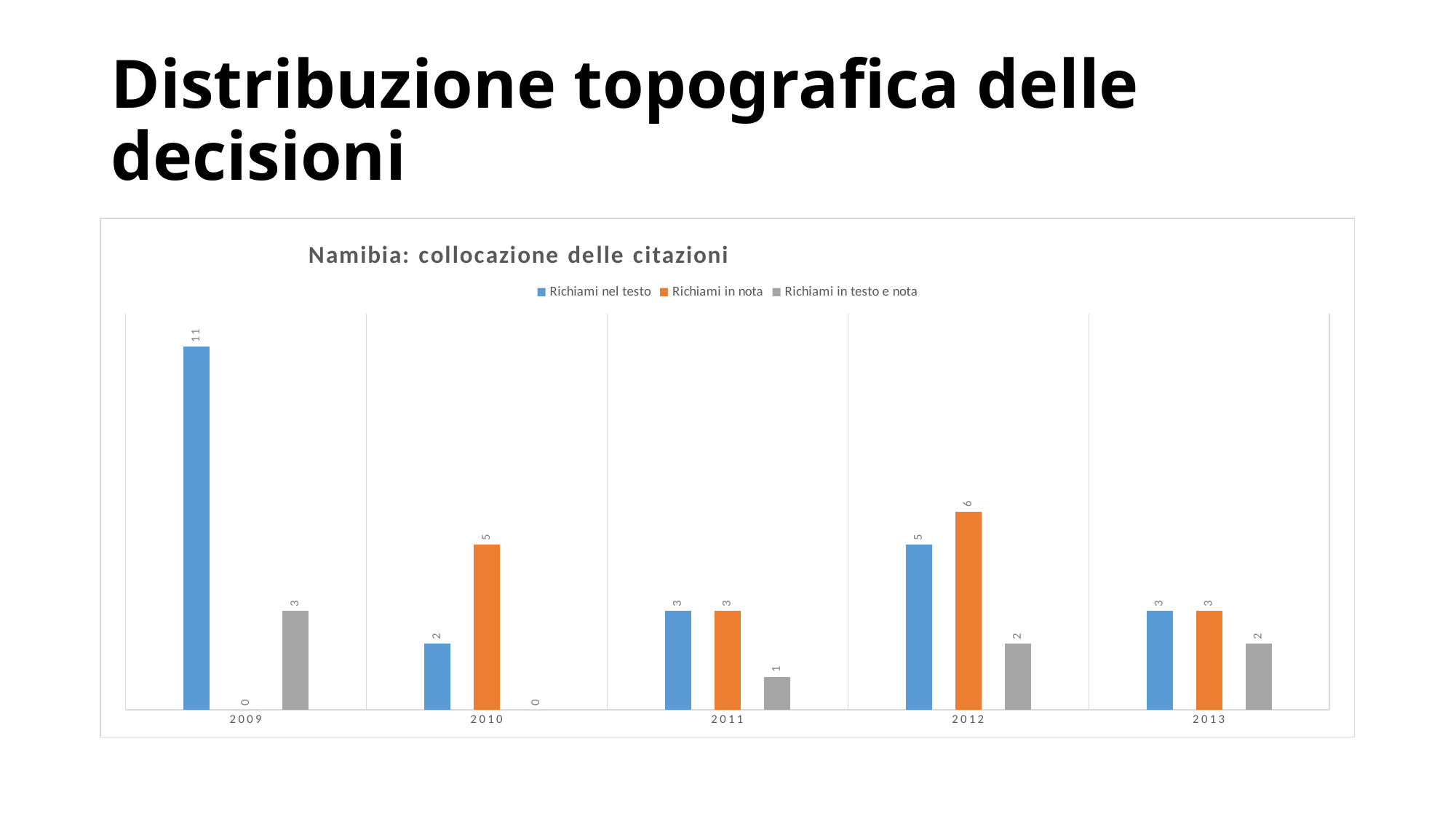
Which year has the lowest value for Richiami nel testo? 2010 What is the value of Richiami in testo e nota for 2011? 1 Which is larger in 2010: Richiami nel testo or Richiami in nota? Richiami in nota What is the value of Richiami nel testo for 2009? 11 What is the value of Richiami in nota for 2010? 5 What is the value of Richiami in nota for 2012? 6 What is the difference between Richiami in nota and Richiami nel testo in 2012? 1 How many series does the legend list? 3 How many years are shown on the x axis? 5 Which year has the highest value for Richiami nel testo? 2009 What kind of chart is shown? Bar chart What is the title of the chart? Namibia: collocazione delle citazioni